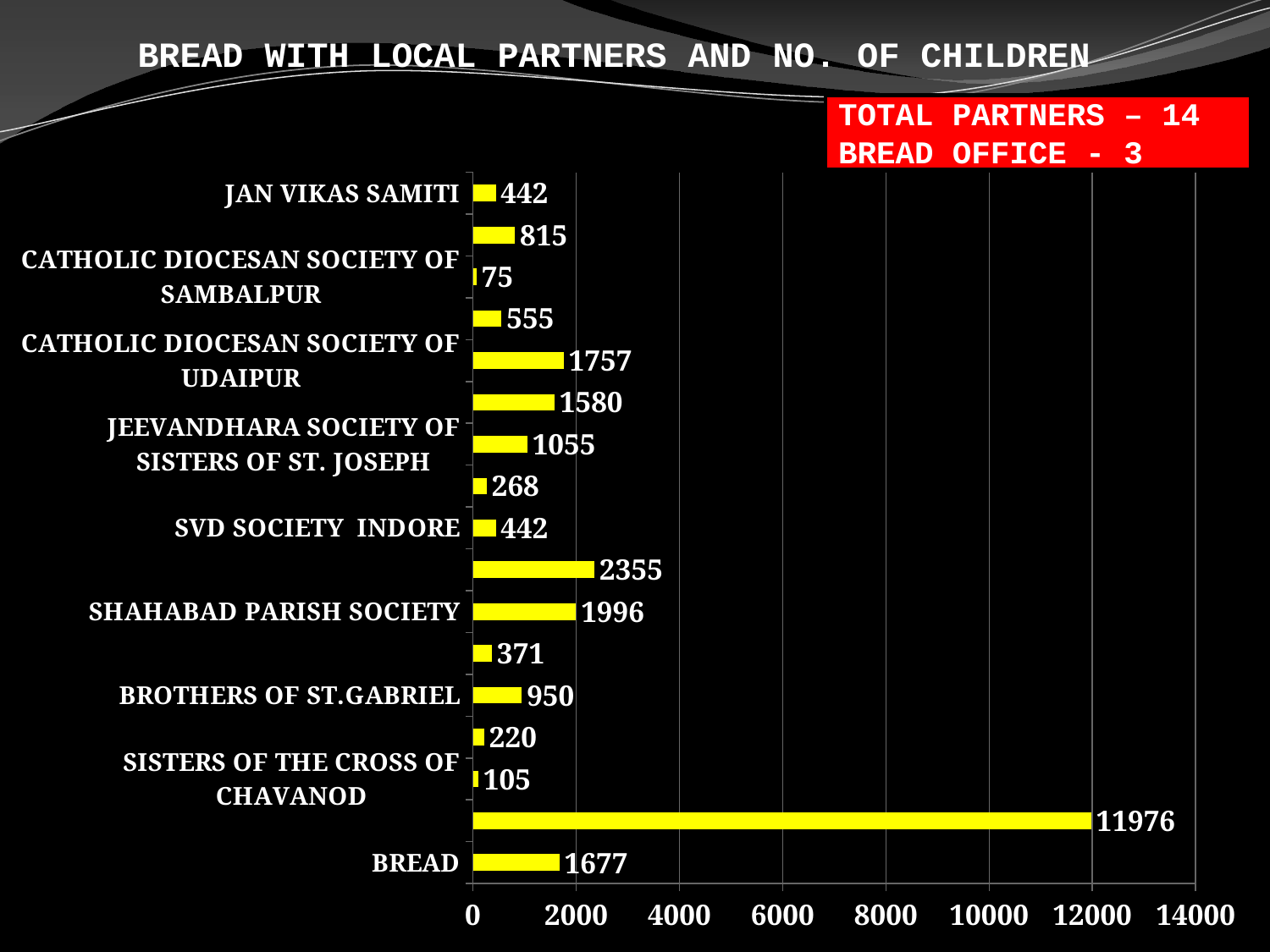
What is the number of children for CATHOLIC DIOCESAN SOCIETY OF UDAIPUR? 1757 What is the title of the slide? BREAD WITH LOCAL PARTNERS AND NO. OF CHILDREN How many bars are plotted on the chart? 17 What is the difference between the values for SHAHABAD PARISH SOCIETY and BREAD? 319 What is the number of children for JAN VIKAS SAMITI? 442 Is the value for CATHOLIC DIOCESAN SOCIETY OF UDAIPUR greater or less than 2000? less What is the number of children for SHAHABAD PARISH SOCIETY? 1996 What is the number of children for SISTERS OF THE CROSS OF CHAVANOD? 105 What is the number of children for BREAD? 1677 What type of chart is shown on the slide? bar chart Which has more children, BROTHERS OF ST.GABRIEL or JEEVANDHARA SOCIETY OF SISTERS OF ST. JOSEPH? JEEVANDHARA SOCIETY OF SISTERS OF ST. JOSEPH What is the largest value shown on the chart? 11976